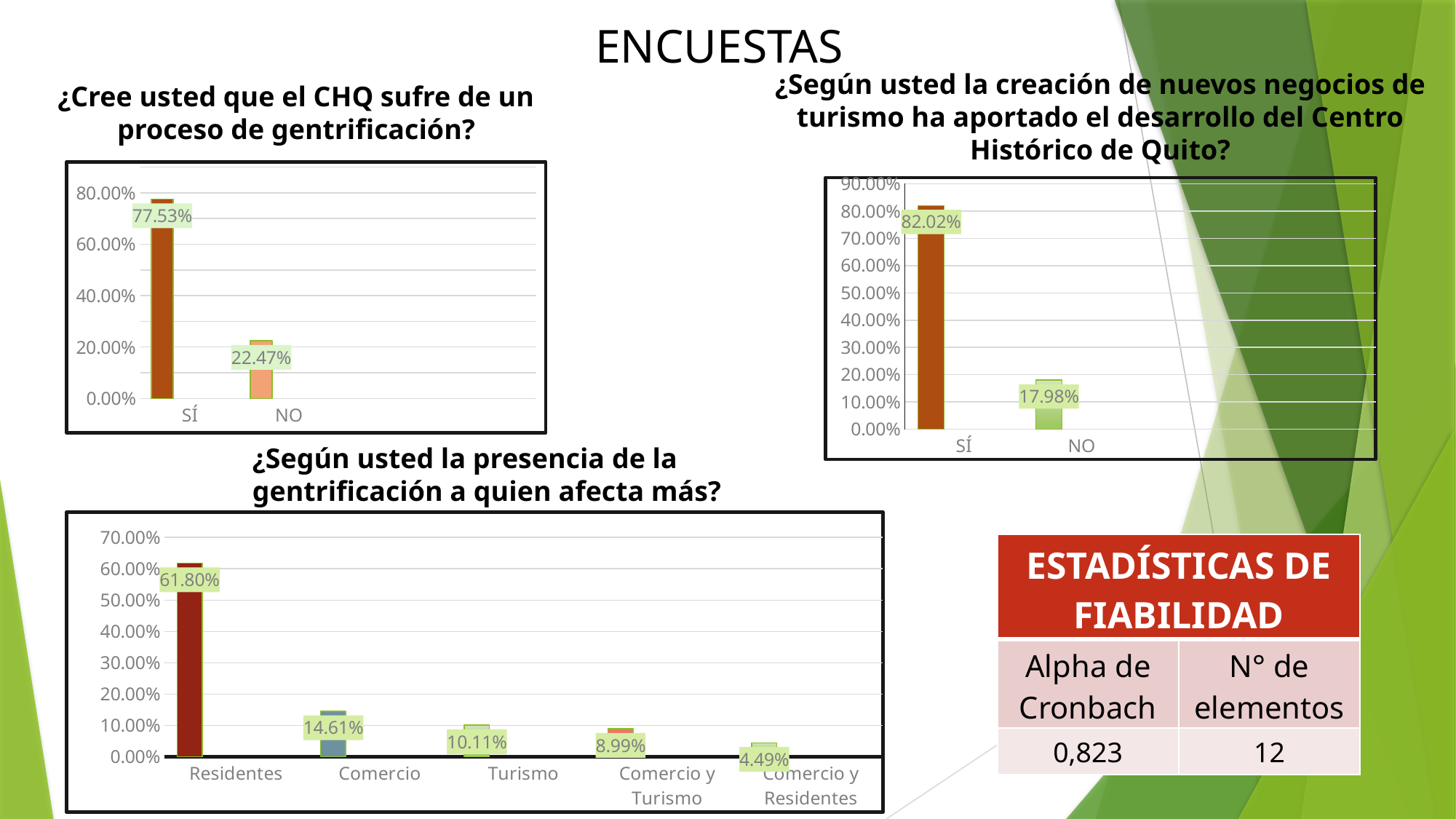
In the chart titled '¿Según usted la presencia de la gentrificación a quien afecta más?', what is the value for Residentes? 61.80% In the chart titled '¿Cree usted que el CHQ sufre de un proceso de gentrificación?', what is the value for NO? 22.47% In the chart titled '¿Según usted la creación de nuevos negocios de turismo ha aportado el desarrollo del Centro Histórico de Quito?', which category is lowest? NO In the chart titled '¿Según usted la presencia de la gentrificación a quien afecta más?', how many categories are shown on the x axis? 5 What kind of chart is the one titled '¿Según usted la presencia de la gentrificación a quien afecta más?'? Bar chart In the chart titled '¿Según usted la presencia de la gentrificación a quien afecta más?', which category has the lowest value? Comercio y Residentes In the chart titled '¿Según usted la creación de nuevos negocios de turismo ha aportado el desarrollo del Centro Histórico de Quito?', what is the value for SÍ? 82.02% In the chart titled '¿Según usted la creación de nuevos negocios de turismo ha aportado el desarrollo del Centro Histórico de Quito?', what is the value for NO? 17.98% In the chart titled '¿Según usted la presencia de la gentrificación a quien afecta más?', what is the difference between the Residentes and Comercio values? 47.19% In the chart titled '¿Según usted la presencia de la gentrificación a quien afecta más?', what is the value for Comercio y Turismo? 8.99% In the chart titled '¿Cree usted que el CHQ sufre de un proceso de gentrificación?', what is the difference between the SÍ and NO values? 55.06% In the chart titled '¿Cree usted que el CHQ sufre de un proceso de gentrificación?', what is the value for SÍ? 77.53%